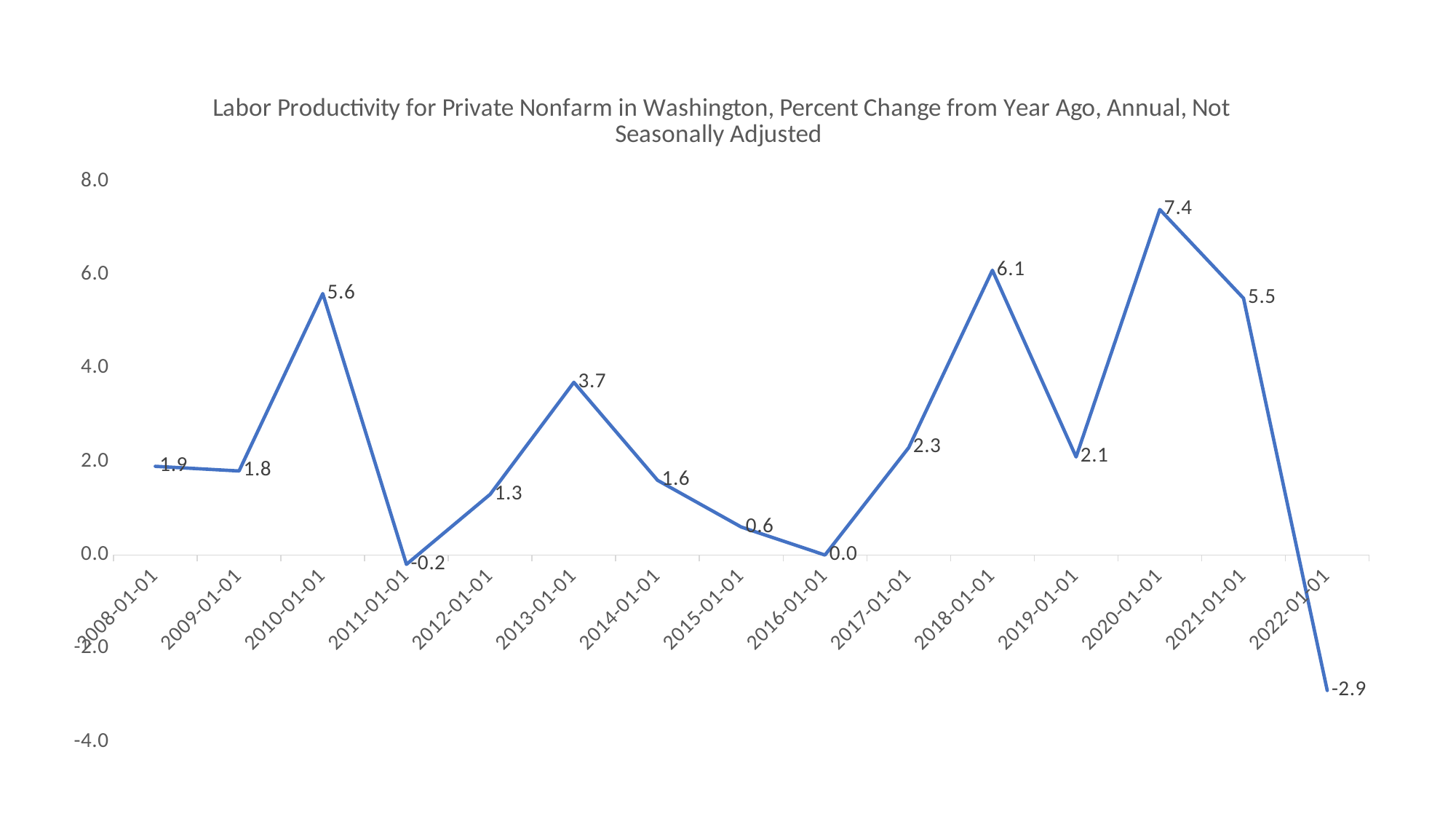
Which year has the highest value? 2020-01-01 Do the values rise or fall from 2018-01-01 to 2019-01-01? fall Which is larger, the value for 2013-01-01 or the value for 2018-01-01? 2018-01-01 How many data points are plotted on the chart? 15 What is the value for 2016-01-01? 0.0 What kind of chart is shown? line chart What is the value for 2010-01-01? 5.6 Is the value for 2019-01-01 greater or less than 4.0? less Which year has the lowest value? 2022-01-01 What is the title of the chart? Labor Productivity for Private Nonfarm in Washington, Percent Change from Year Ago, Annual, Not Seasonally Adjusted What is the value for 2022-01-01? -2.9 What is the difference between the values for 2020-01-01 and 2021-01-01? 1.9